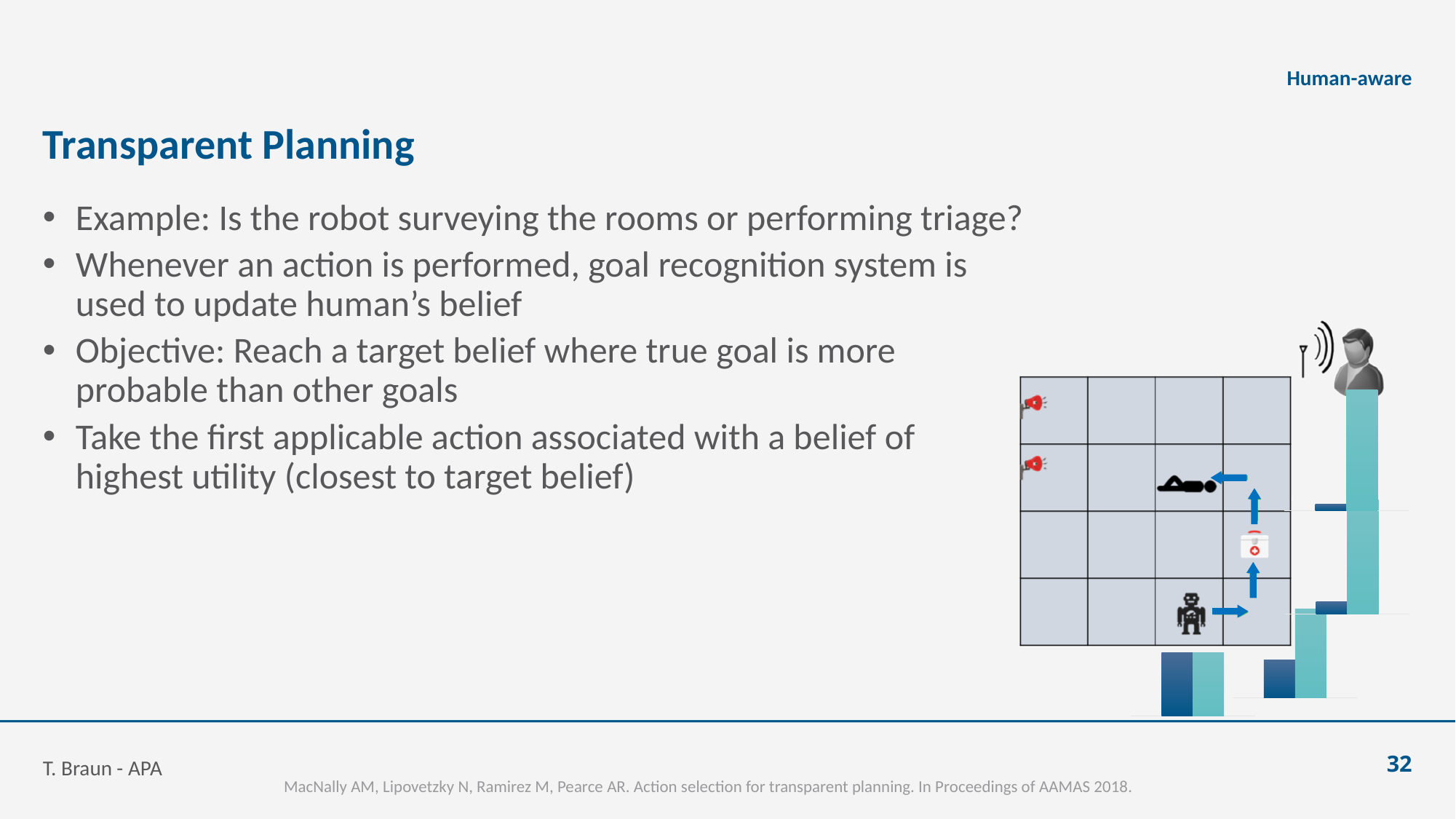
How many bars are in each group of the bar chart at the bottom right of the slide? 2 Does the bar chart at the bottom right of the slide have a legend? No What kind of chart is shown at the bottom right of the slide? bar chart What two colours are used for the bars in the chart at the bottom right of the slide? dark blue and teal In the bar chart at the bottom right of the slide, do the teal bars rise or fall from left to right? rise